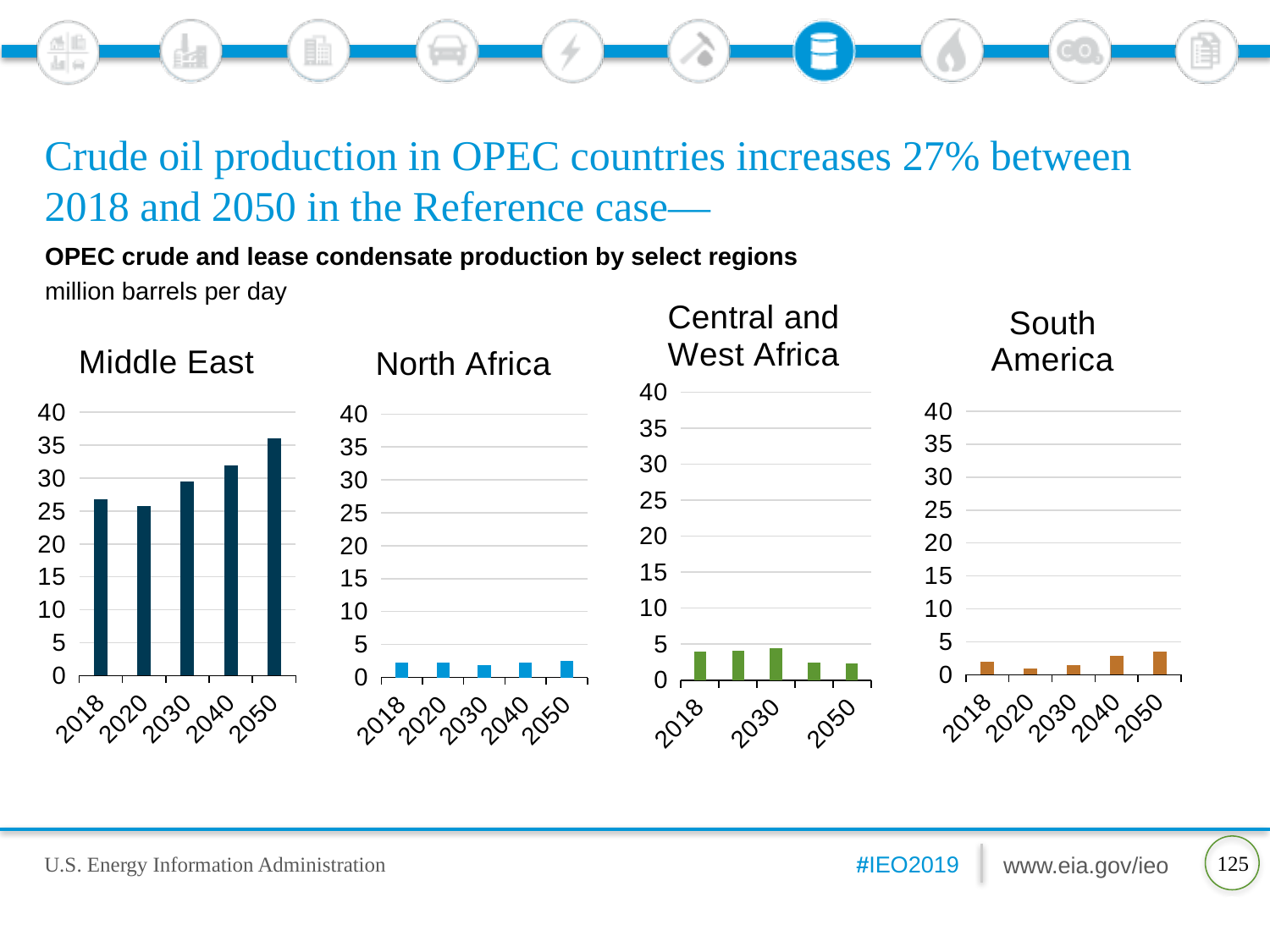
In the Central and West Africa chart, which year has the highest production? 2030 How many charts are shown on the slide? 4 In the Middle East chart, is the value for 2018 greater or less than 25? greater In the North Africa chart, is the value for 2050 greater or less than 5? less What kind of chart is the Middle East chart? bar chart In the Middle East chart, how many years are shown on the x axis? 5 What unit of measurement is used for the charts on the slide? million barrels per day In the South America chart, which year has the lowest production? 2020 In the Middle East chart, which year has the highest production? 2050 In the Middle East chart, is the value for 2050 greater or less than 30? greater In the Middle East chart, do the values generally rise or fall from 2018 to 2050? rise In the Middle East chart, which is larger, the value for 2050 or the value for 2018? 2050